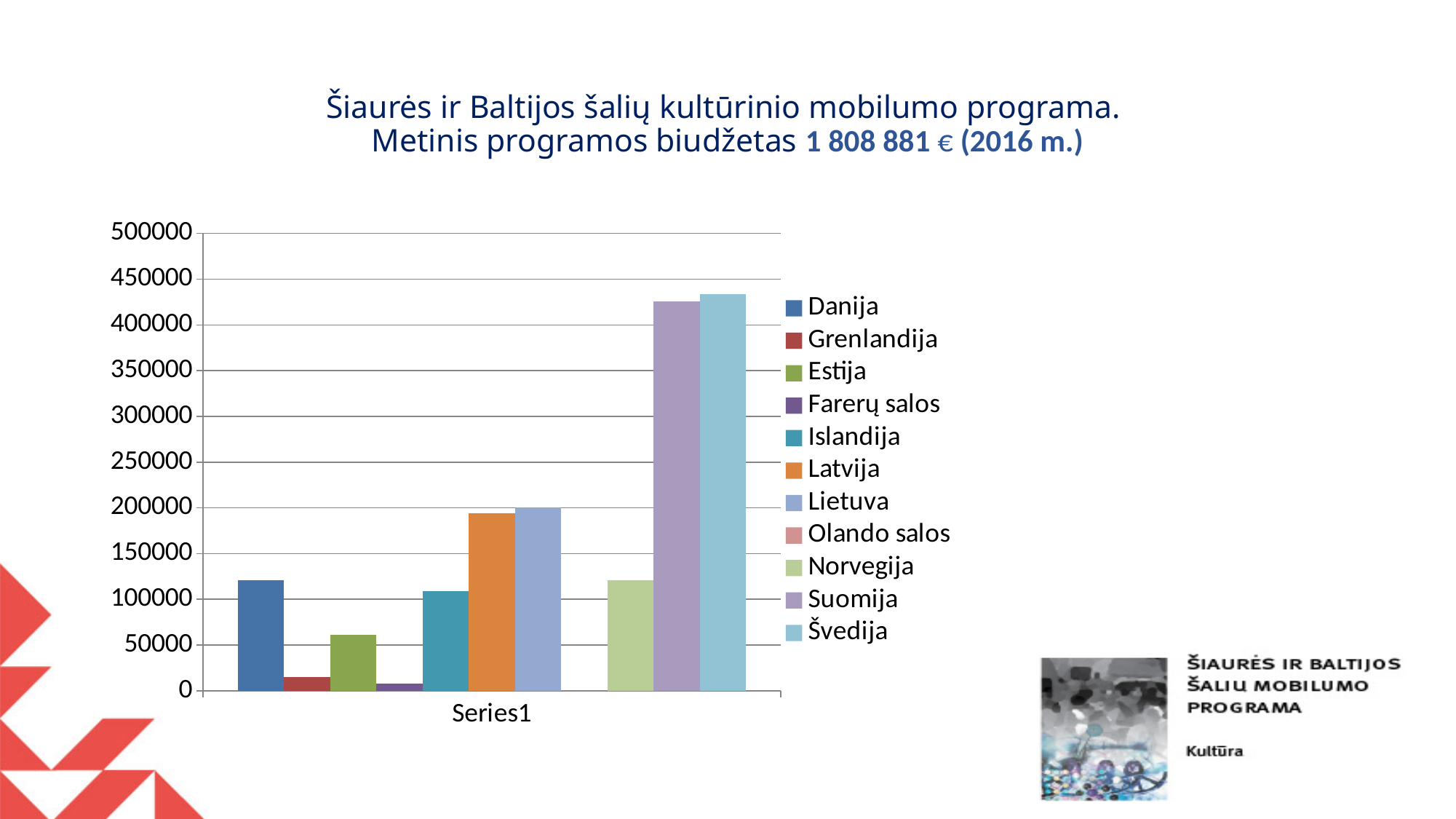
Which is larger, the value for Latvija or the value for Estija? Latvija Is the value for Danija greater or less than 100000? greater Is the value for Suomija greater or less than 400000? greater Is the value for Grenlandija greater or less than 50000? less What kind of chart is shown on the slide? bar chart How many entries does the chart legend list? 11 What label is shown on the x axis of the chart? Series1 Which is larger, the value for Suomija or the value for Lietuva? Suomija Which is larger, the value for Danija or the value for Grenlandija? Danija